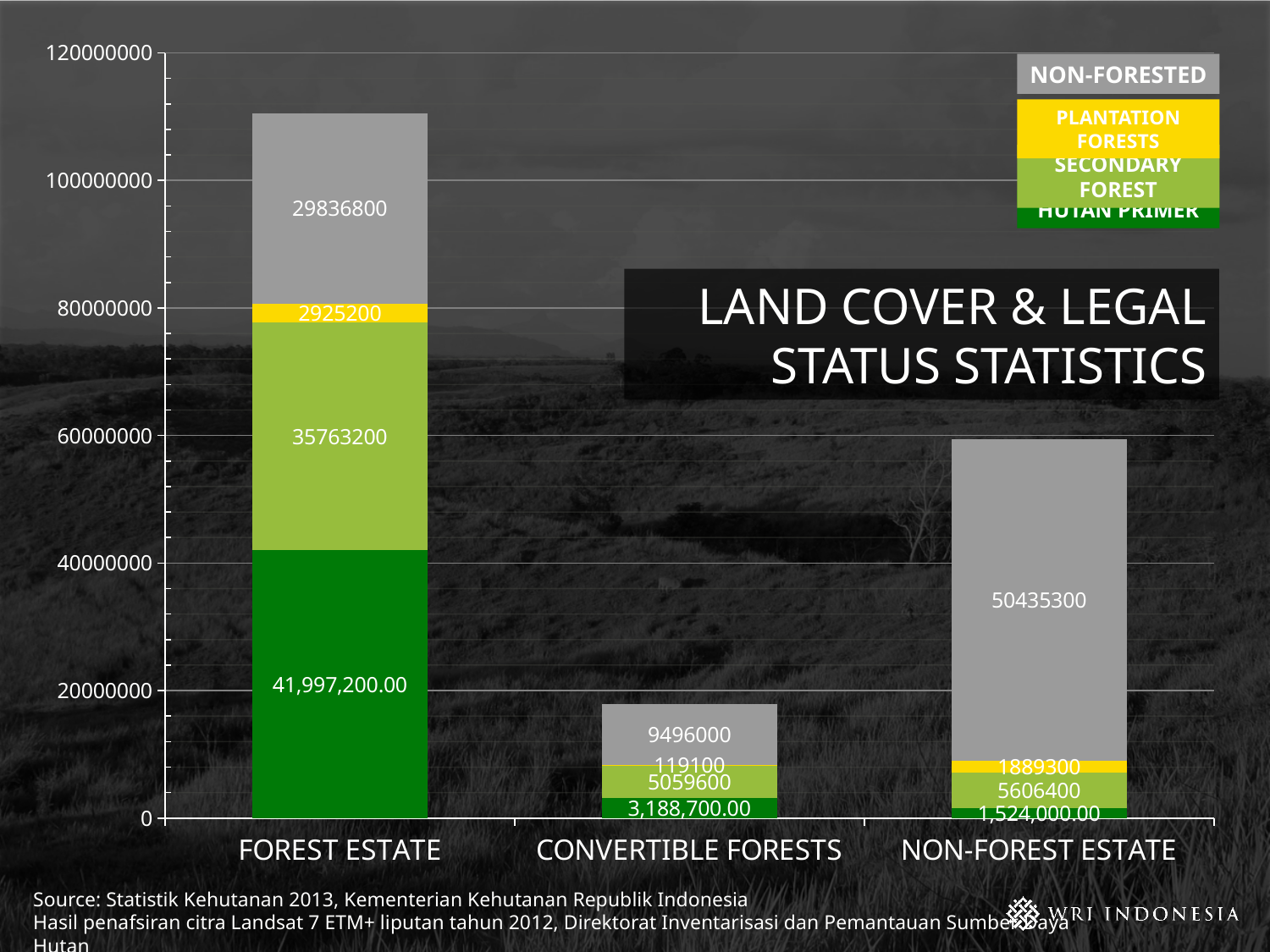
Which category has the tallest stacked bar overall? FOREST ESTATE What is the difference between the NON-FORESTED values for NON-FOREST ESTATE and FOREST ESTATE? 20598500 How many categories are shown on the x axis? 3 How many series does the legend list? 4 What kind of chart is shown on the slide? Stacked bar chart What is the HUTAN PRIMER value for FOREST ESTATE? 41,997,200.00 What is the NON-FORESTED value for NON-FOREST ESTATE? 50435300 Which category has the smallest HUTAN PRIMER value? NON-FOREST ESTATE What is the SECONDARY FOREST value for CONVERTIBLE FORESTS? 5059600 What is the PLANTATION FORESTS value for NON-FOREST ESTATE? 1889300 What is the total of the stacked bar for CONVERTIBLE FORESTS? 17863400 Which is larger: the SECONDARY FOREST value for NON-FOREST ESTATE or for CONVERTIBLE FORESTS? NON-FOREST ESTATE